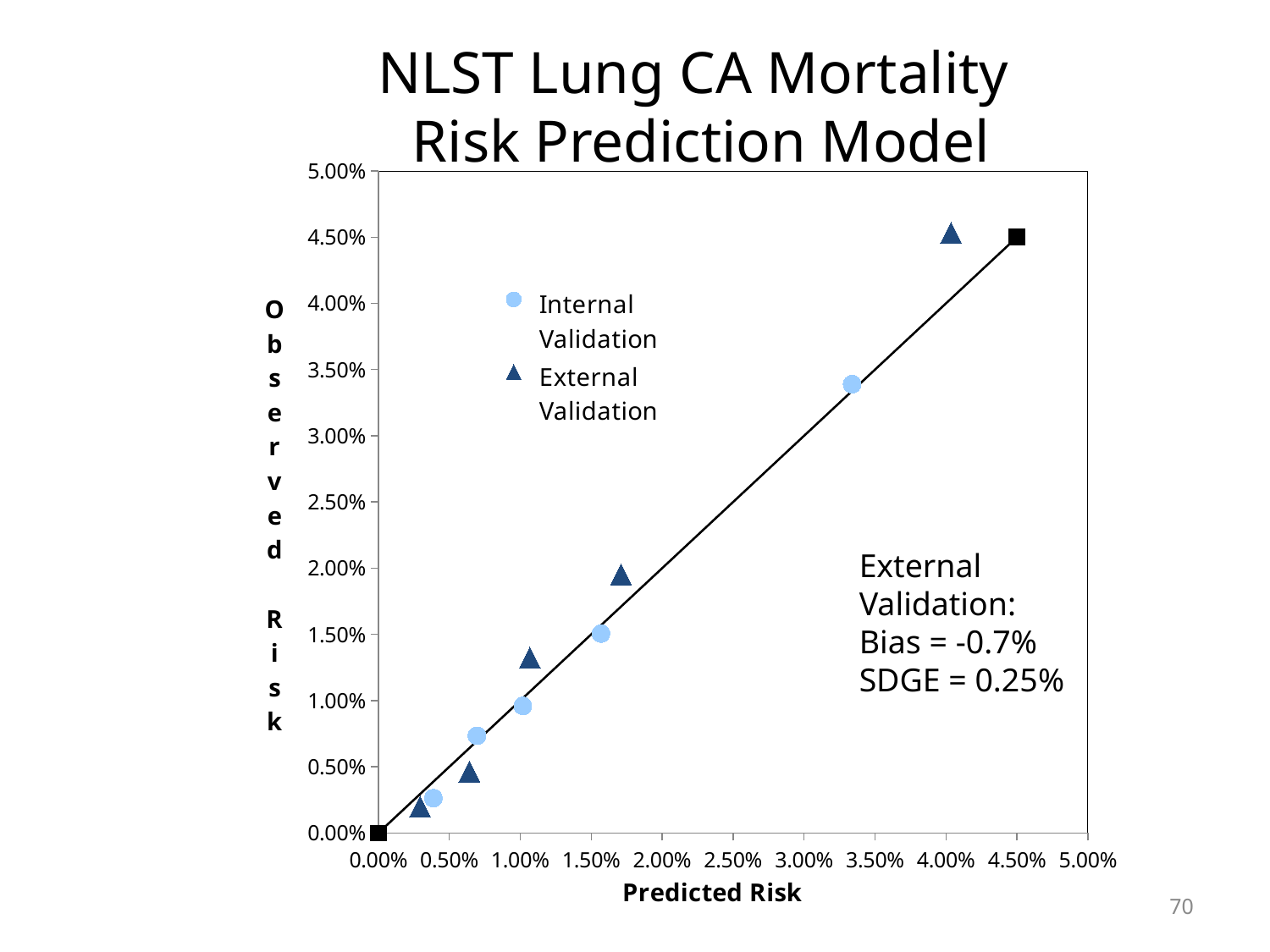
How many Internal Validation points are plotted? 5 Which series contains the point with the highest observed risk, Internal Validation or External Validation? External Validation How many series does the legend list? 2 Is the observed risk of the highest External Validation point greater or less than 4.00%? greater Is the observed risk of the lowest Internal Validation point greater or less than 0.50%? less As predicted risk increases along the x axis, does observed risk rise or fall? Rise What is the label of the x axis? Predicted Risk Is the observed risk of the highest Internal Validation point greater or less than 3.00%? greater What are the two series named in the legend? Internal Validation and External Validation What kind of chart is shown on the slide? Scatter chart What is the maximum value shown on the y axis? 5.00% How many External Validation points are plotted? 5